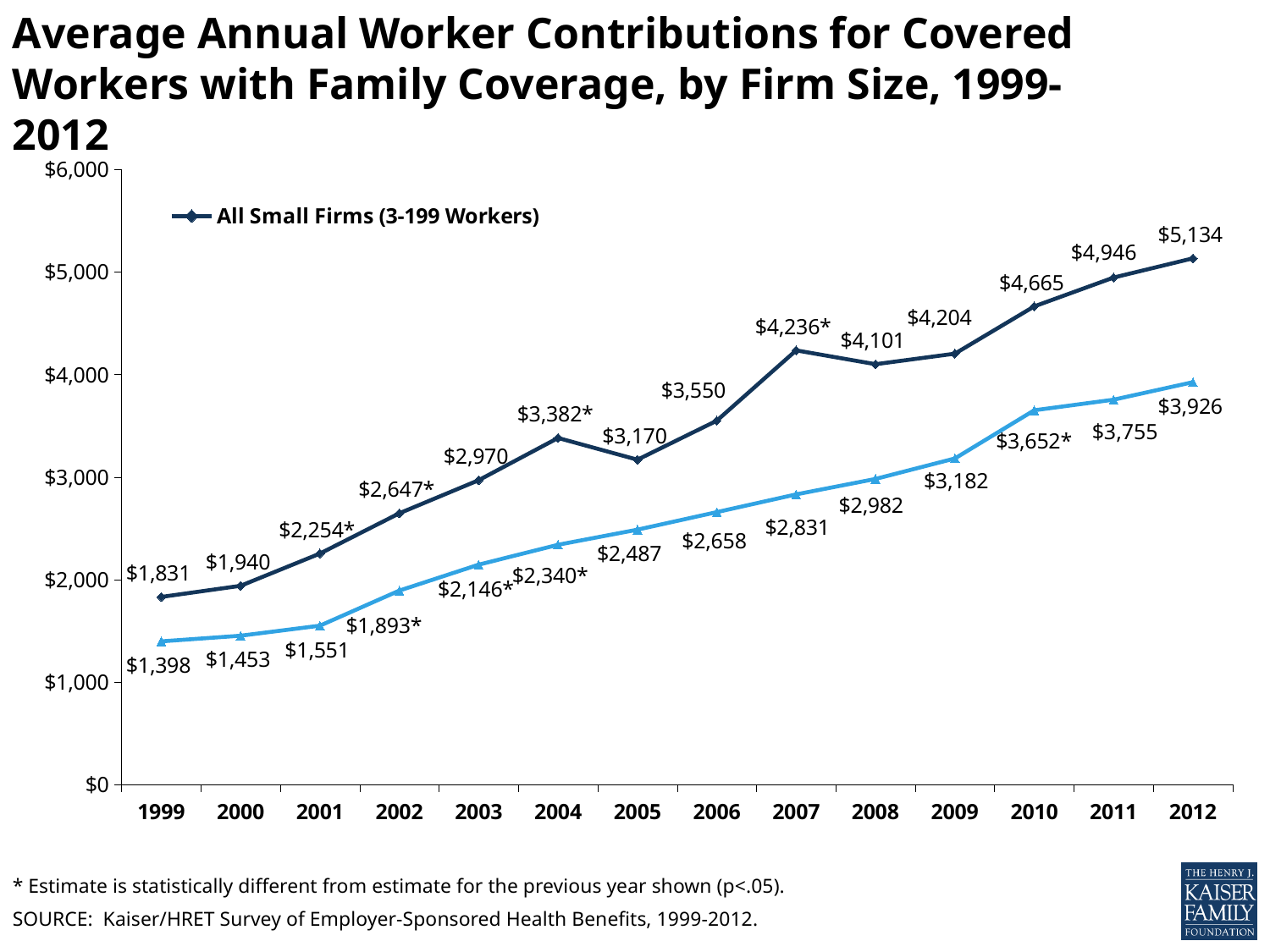
In which year is the All Small Firms (3-199 Workers) value highest? 2012 What kind of chart is shown on the slide? line chart In which year is the All Small Firms (3-199 Workers) value lowest? 1999 What is the value for All Small Firms (3-199 Workers) in 1999? $1,831 How many series does the legend list? 1 What is the difference between the All Small Firms (3-199 Workers) values for 2012 and 1999? $3,303 How many years are shown on the x axis? 14 Do the All Small Firms (3-199 Workers) values generally rise or fall from 1999 to 2012? rise What is the value for All Small Firms (3-199 Workers) in 2007? $4,236* What is the value for All Small Firms (3-199 Workers) in 2012? $5,134 For All Small Firms (3-199 Workers), which year has the larger value, 2004 or 2005? 2004 Is the All Small Firms (3-199 Workers) value for 2010 greater or less than $4,000? greater